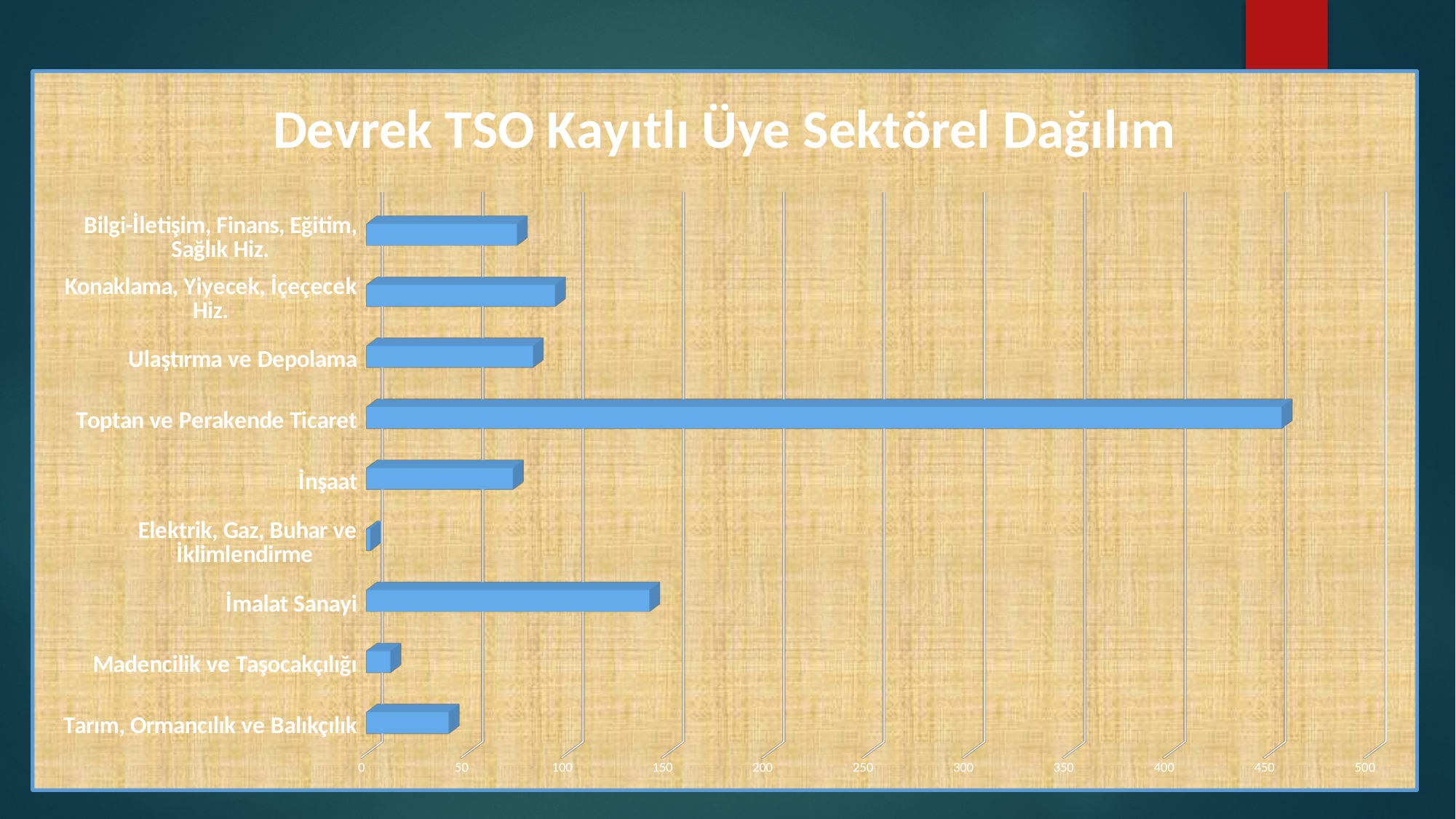
How many sector categories are plotted in the chart? 9 Is the value for İmalat Sanayi greater or less than 100? greater Is the value for Tarım, Ormancılık ve Balıkçılık greater or less than 50? less Which is larger, the value for Tarım, Ormancılık ve Balıkçılık or the value for Madencilik ve Taşocakçılığı? Tarım, Ormancılık ve Balıkçılık Which sector has the lowest value? Elektrik, Gaz, Buhar ve İklimlendirme What is the title of the chart? Devrek TSO Kayıtlı Üye Sektörel Dağılım Is the value for Toptan ve Perakende Ticaret greater or less than 400? greater Which is larger, the value for İmalat Sanayi or the value for İnşaat? İmalat Sanayi What kind of chart is shown on the slide? bar chart Which sector has the highest value? Toptan ve Perakende Ticaret What is the maximum value shown on the horizontal axis? 500